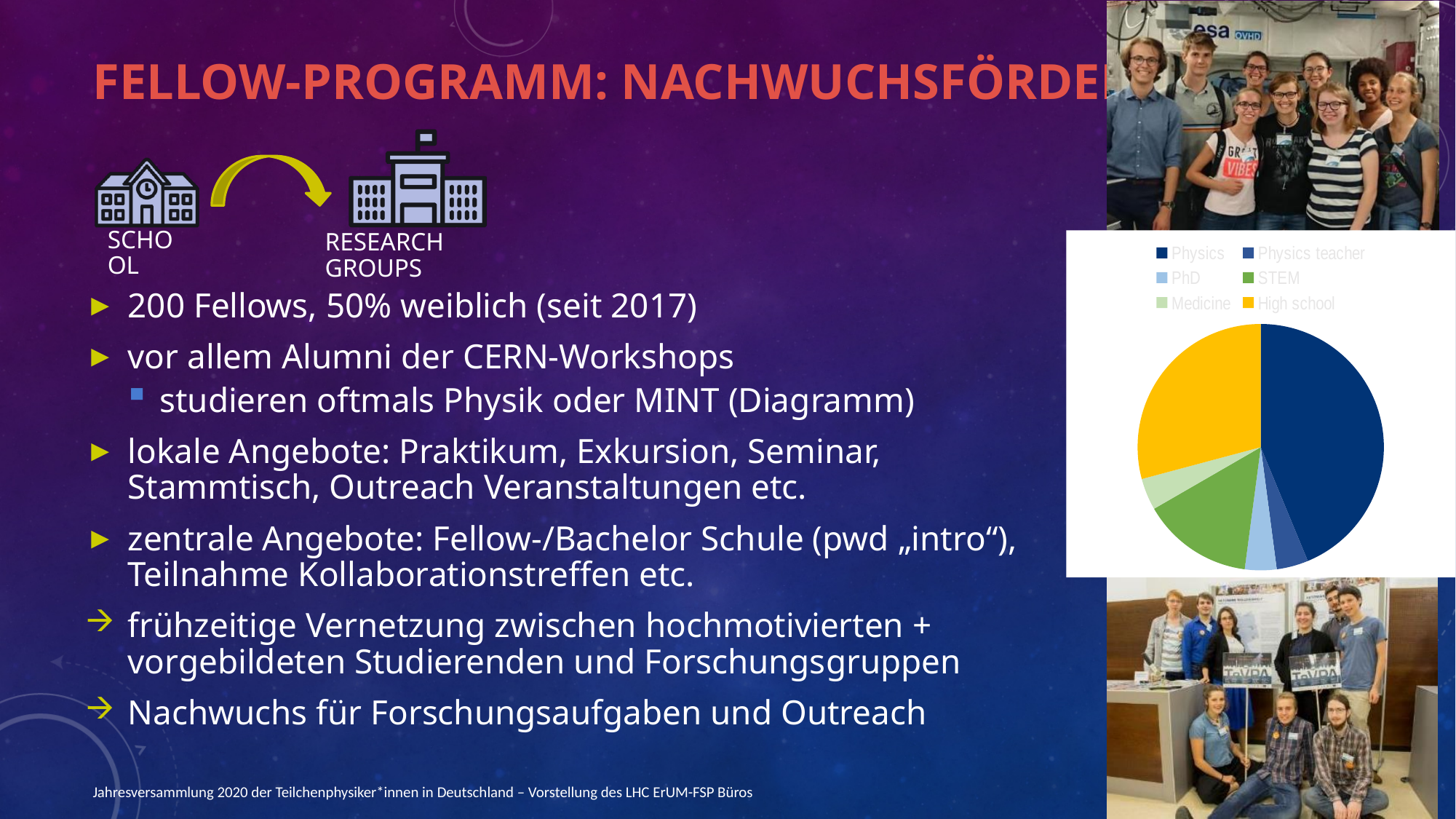
How many categories does the pie chart have? 6 In the pie chart, which slice is larger: STEM or Medicine? STEM How many entries does the legend of the pie chart list? 6 Which category has the largest slice in the pie chart? Physics What kind of chart is shown on the slide? pie chart In the pie chart, which slice is larger: Physics or STEM? Physics In the pie chart, which slice is larger: High school or STEM? High school Which colour represents High school in the pie chart legend? yellow Which category in the pie chart legend is shown in green? STEM